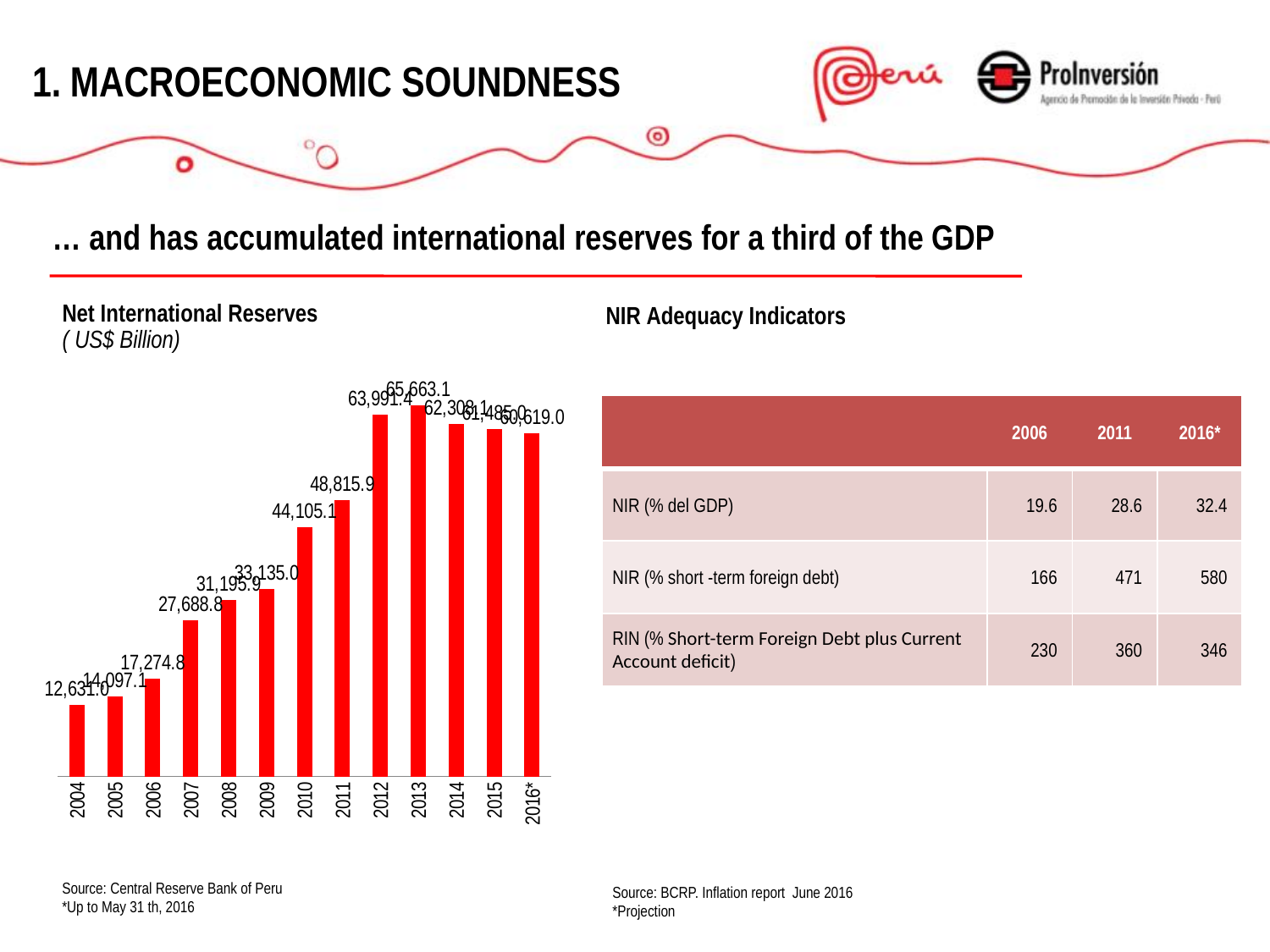
In the Net International Reserves chart, what is the value for 2010? 44,105.1 Which year has the highest value in the Net International Reserves chart? 2013 In the Net International Reserves chart, what is the value for 2004? 12,631.0 In the Net International Reserves chart, do the values rise or fall from 2004 to 2013? rise Which year has the lowest value in the Net International Reserves chart? 2004 In the Net International Reserves chart, what is the value for 2011? 48,815.9 In the Net International Reserves chart, what is the value for 2009? 33,135.0 What kind of chart is used to show Net International Reserves? bar chart In the Net International Reserves chart, what is the value for 2007? 27,688.8 How many years are shown on the x axis of the Net International Reserves chart? 13 In the Net International Reserves chart, what is the difference between the 2011 and 2010 values? 4,710.8 In the Net International Reserves chart, which year has the larger value, 2007 or 2008? 2008